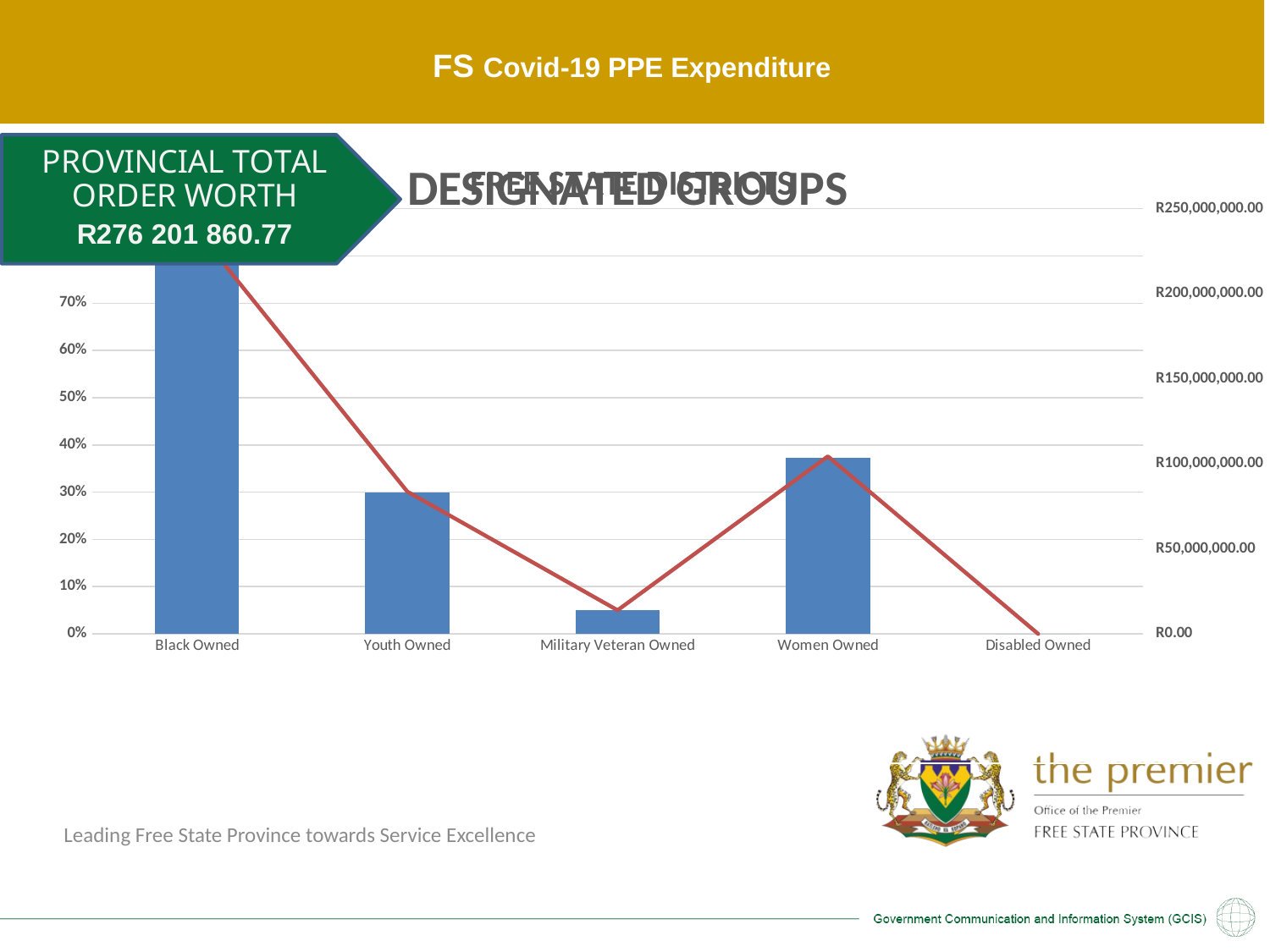
Is the bar value for Military Veteran Owned greater or less than 10%? less Is the bar value for Black Owned greater or less than 70%? greater What kind of chart is this? Bar chart with a line overlay Which category has the lowest bar? Disabled Owned Is the bar value for Women Owned greater or less than 30%? greater Which bar is taller, Military Veteran Owned or Youth Owned? Youth Owned Which category has the tallest bar? Black Owned Which bar is taller, Youth Owned or Women Owned? Women Owned Does the red line rise or fall from Black Owned to Military Veteran Owned? fall What is the highest tick label on the right-hand axis? R250,000,000.00 How many categories are shown on the x axis? 5